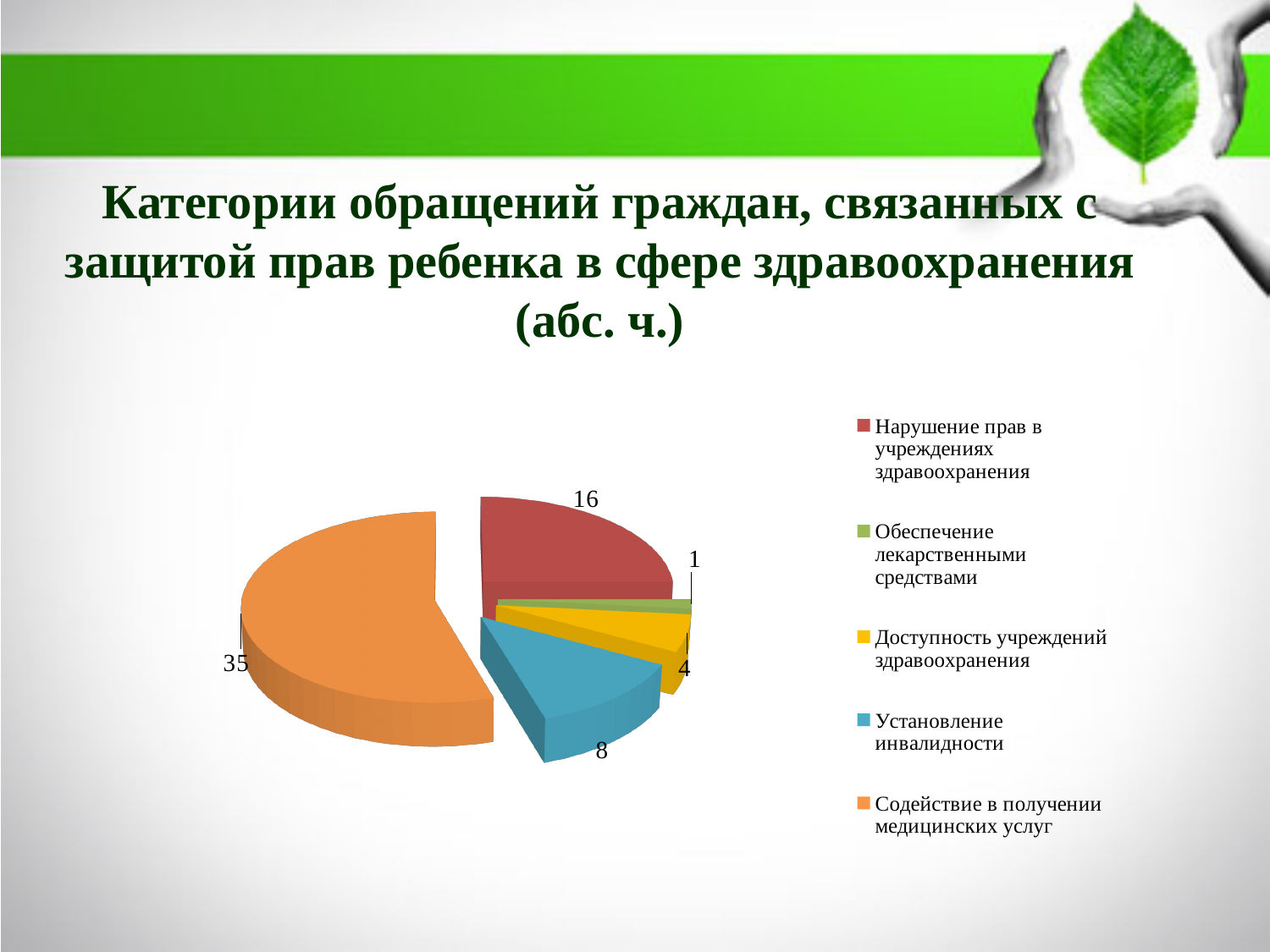
What is the value for "Содействие в получении медицинских услуг"? 35 Which is larger: the value for "Установление инвалидности" or for "Доступность учреждений здравоохранения"? Установление инвалидности What is the value for "Установление инвалидности"? 8 Which category has the largest slice of the pie? Содействие в получении медицинских услуг What colour is the slice for "Установление инвалидности"? blue Which category has the smallest slice of the pie? Обеспечение лекарственными средствами What is the value for "Нарушение прав в учреждениях здравоохранения"? 16 What share of the pie does "Нарушение прав в учреждениях здравоохранения" represent? 25% What is the value for "Обеспечение лекарственными средствами"? 1 What is the difference between the values for "Содействие в получении медицинских услуг" and "Нарушение прав в учреждениях здравоохранения"? 19 What type of chart is shown on the slide? pie chart How many categories does the pie chart have? 5